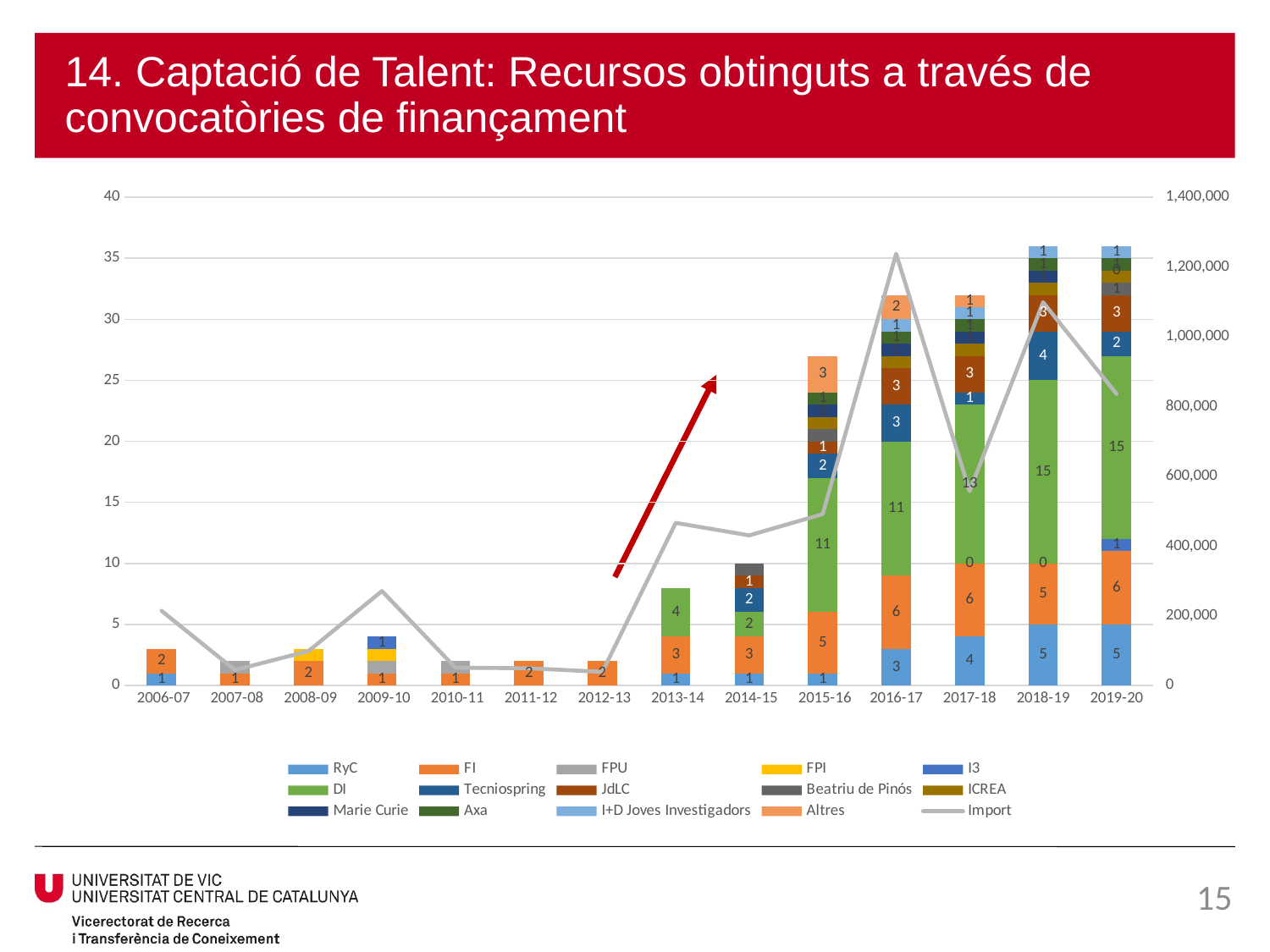
What type of chart is shown on the slide? Stacked bar chart with a line How many academic years are shown on the x axis? 14 Which colour represents the DI series in the legend? Green Which is larger, the DI segment for 2015-16 or the DI segment for 2018-19? 2018-19 What is the value of the RyC segment for 2017-18? 4 What is the value of the DI segment for 2013-14? 4 Is the Import line value for 2013-14 greater or less than 400,000? greater What is the difference between the DI segment for 2018-19 and the DI segment for 2013-14? 11 What is the value of the DI segment for 2018-19? 15 What is the value of the FI segment for 2015-16? 5 Does the Import line rise or fall from 2017-18 to 2018-19? rise How many series does the legend list? 15